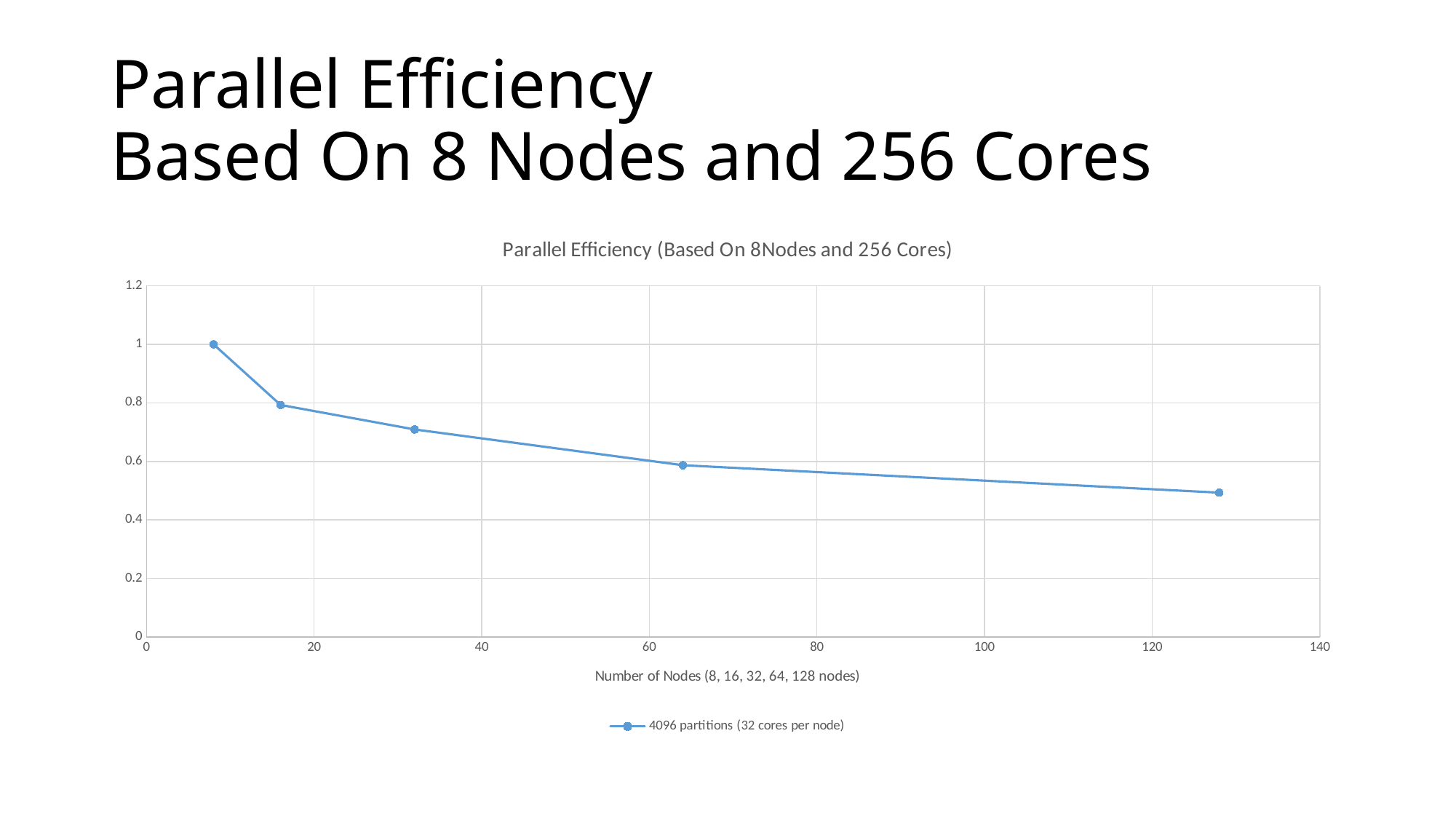
How many series does the legend list? 1 What is the parallel efficiency at 8 nodes? 1 At which number of nodes is the parallel efficiency lowest? 128 Is the parallel efficiency at 128 nodes greater or less than 0.6? less Do the plotted values rise or fall as the number of nodes increases? fall Which has a higher parallel efficiency, 32 nodes or 64 nodes? 32 nodes How many data points are plotted on the chart? 5 What is the x-axis label of the chart? Number of Nodes (8, 16, 32, 64, 128 nodes) What is the legend entry for the plotted series? 4096 partitions (32 cores per node) At which number of nodes is the parallel efficiency highest? 8 Is the parallel efficiency at 16 nodes greater or less than 0.6? greater What kind of chart is shown on the slide? line chart